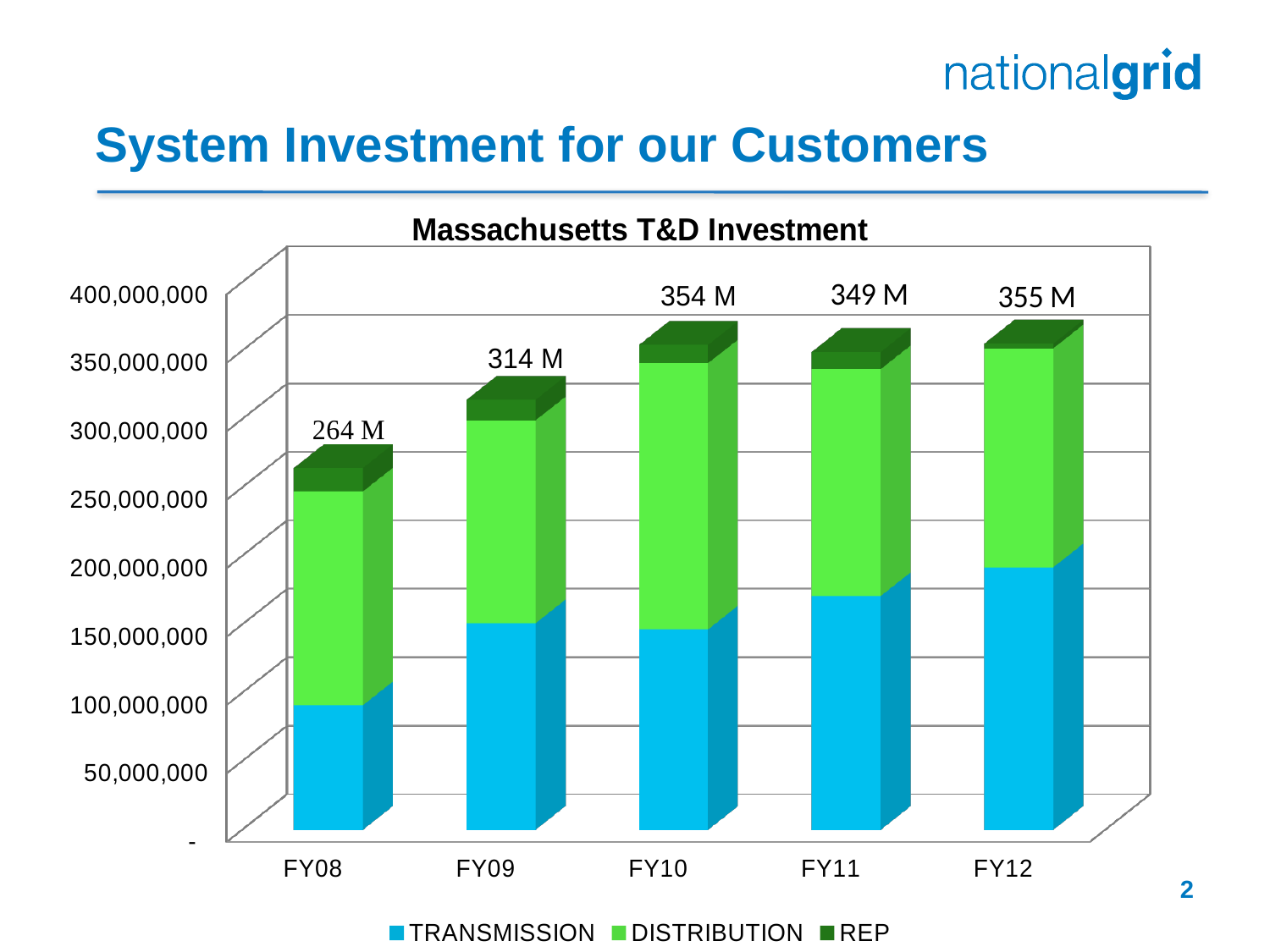
What kind of chart is shown on the slide? Stacked bar chart Which is larger, the labeled total for FY11 or for FY09? FY11 Which fiscal year has the highest labeled total investment? FY12 What is the total investment labeled for FY12? 355 M How many series does the legend list? 3 What is the total Massachusetts T&D Investment labeled for FY08? 264 M What is the difference between the labeled totals for FY09 and FY08? 50 M Which fiscal year has the lowest labeled total investment? FY08 How many fiscal years are shown on the x axis? 5 What is the total investment labeled for FY10? 354 M What is the difference between the labeled totals for FY10 and FY08? 90 M Is the TRANSMISSION value for FY11 greater or less than 150,000,000? greater